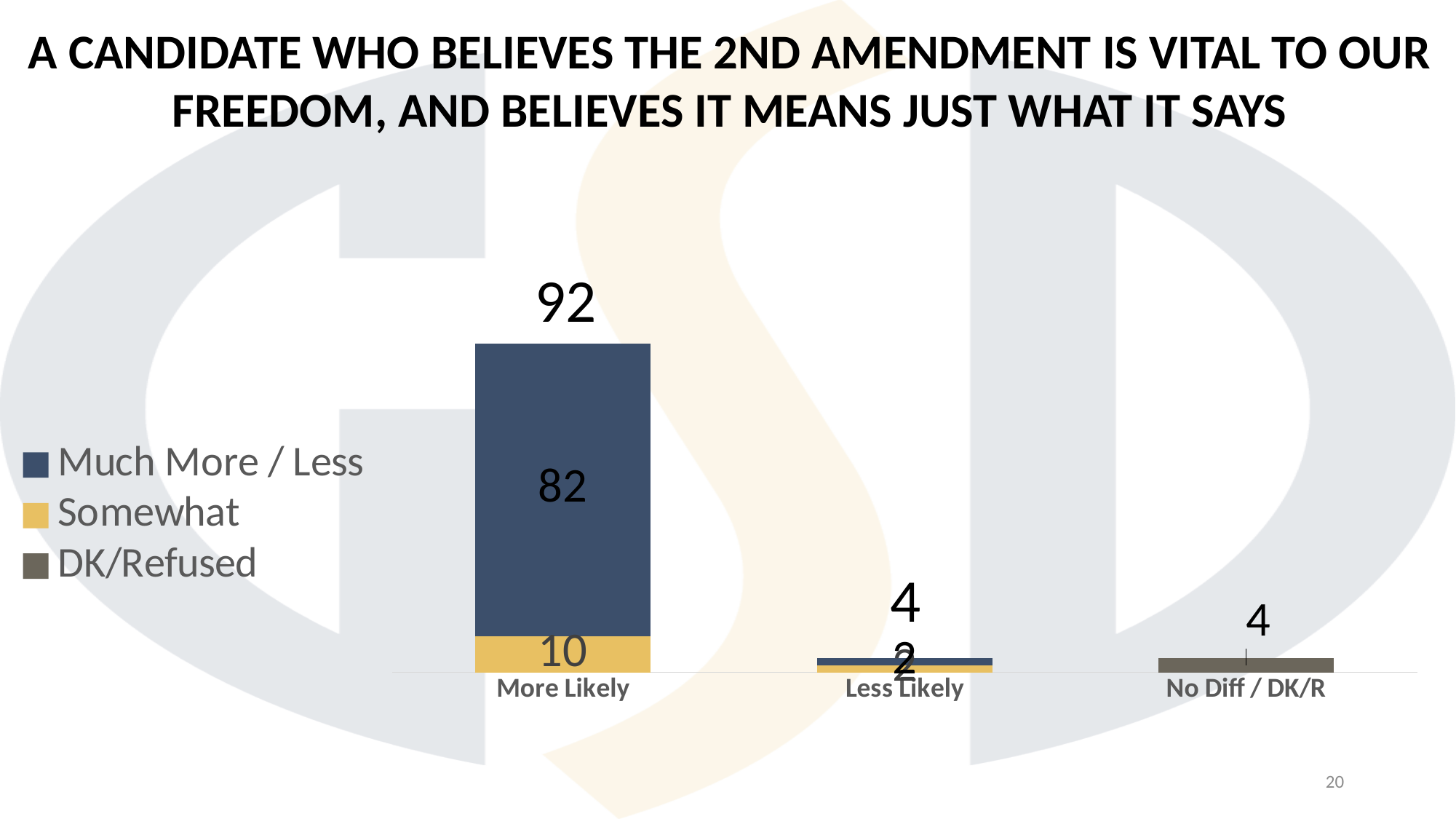
Which is larger, the More Likely total or the No Diff / DK/R value? More Likely total What is the Somewhat value for the More Likely category? 10 What is the total value shown above the Less Likely bar? 4 What is the value for the No Diff / DK/R category? 4 What is the difference between the More Likely total and the Less Likely total? 88 What is the Much More / Less value for the More Likely category? 82 What kind of chart is shown on the slide? Stacked bar chart What is the difference between the Much More / Less value and the Somewhat value in the More Likely category? 72 Which category has the highest total value? More Likely What is the total value shown above the More Likely bar? 92 How many categories are shown on the x axis? 3 How many series does the legend list? 3